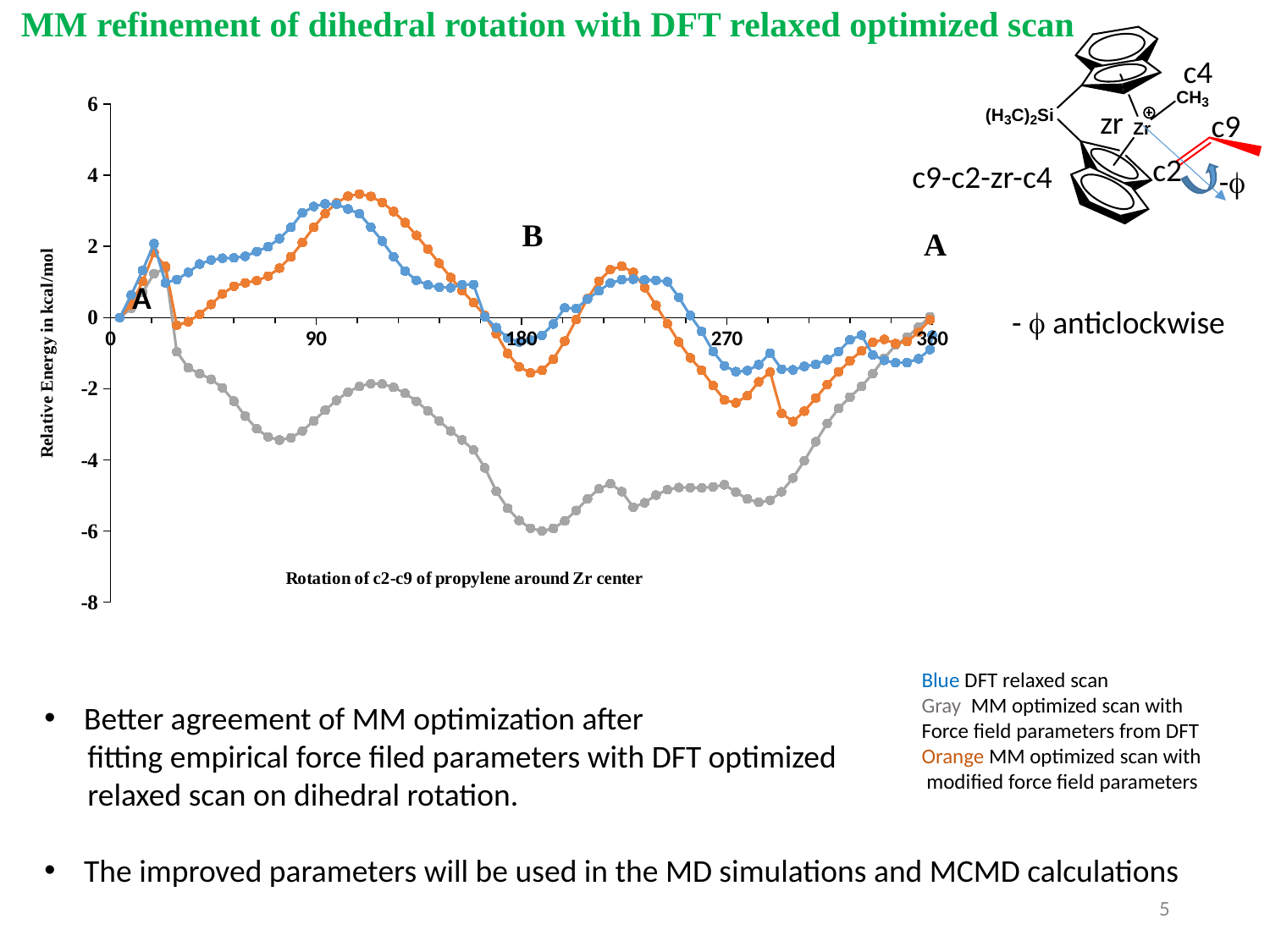
Does the gray series rise or fall overall between 0 and 180 degrees? fall At 90 degrees, which series has the larger value, blue or gray? blue At 180 degrees, which series has the larger value, orange or gray? orange Is the value of the blue series at 90 degrees greater or less than 2? greater What kind of chart is shown on the slide? line chart What text label describes the x axis of the chart? Rotation of c2-c9 of propylene around Zr center What is the title of the y axis of the chart? Relative Energy in kcal/mol Is the value of the orange series at 180 degrees greater or less than 0? less Is the value of the gray series at 90 degrees greater or less than -2? less Which series lies lowest on the chart across the whole rotation range? Gray (MM optimized scan with force field parameters from DFT) How many data series are plotted in the chart? 3